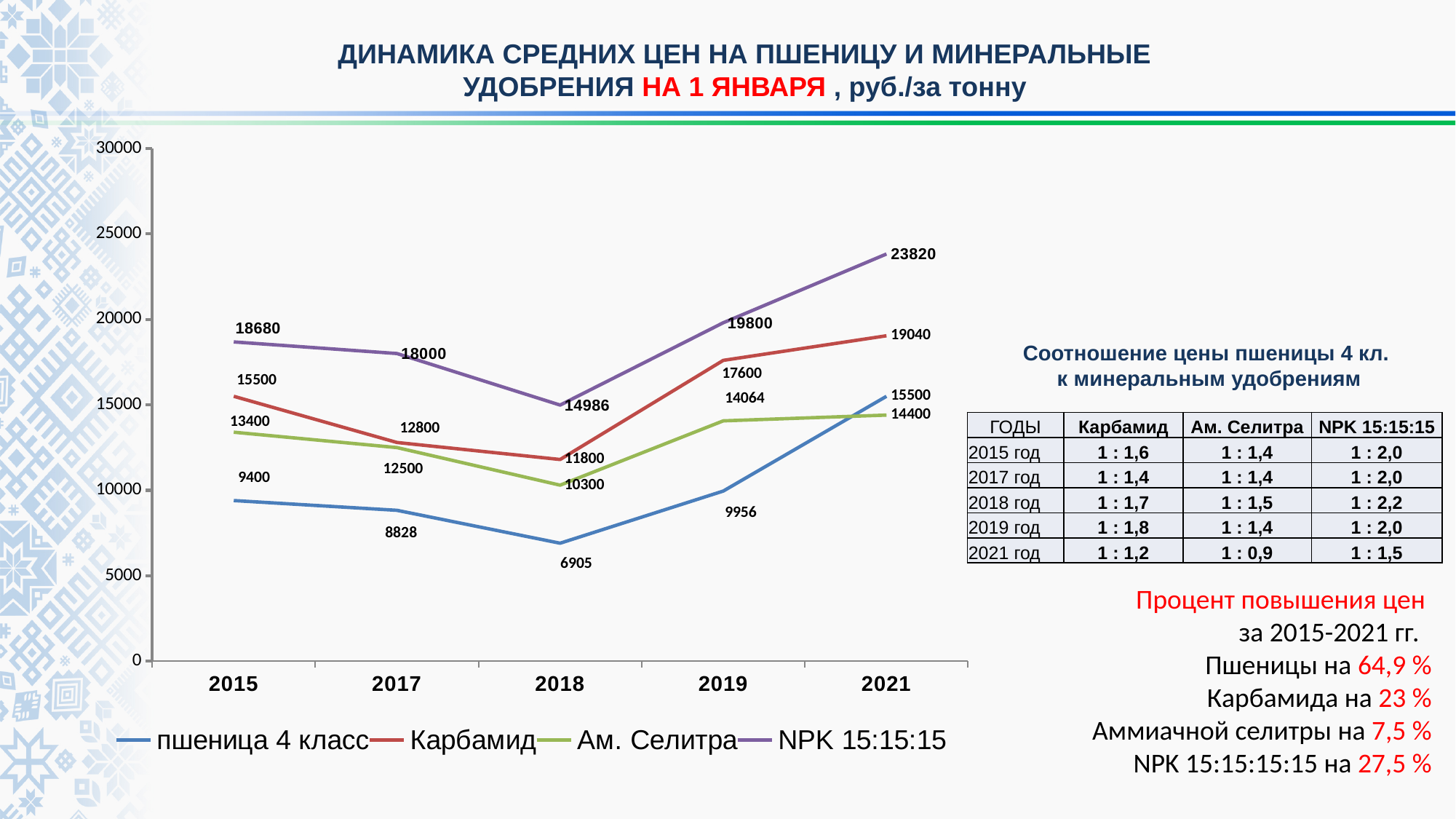
What is the value for пшеница 4 класс in 2018? 6905 In which year is the value for Карбамид highest? 2021 How many series does the chart legend list? 4 What is the value for Ам. Селитра in 2017? 12500 Does the value for пшеница 4 класс rise or fall from 2018 to 2021? rise What is the difference between the NPK 15:15:15 value and the Карбамид value in 2015? 3180 What is the value for NPK 15:15:15 in 2021? 23820 Which is larger in 2021: the value for пшеница 4 класс or the value for Ам. Селитра? пшеница 4 класс What is the value for Карбамид in 2019? 17600 What type of chart is shown on the slide? line chart How many years are plotted along the x axis of the chart? 5 In which year is the value for NPK 15:15:15 lowest? 2018